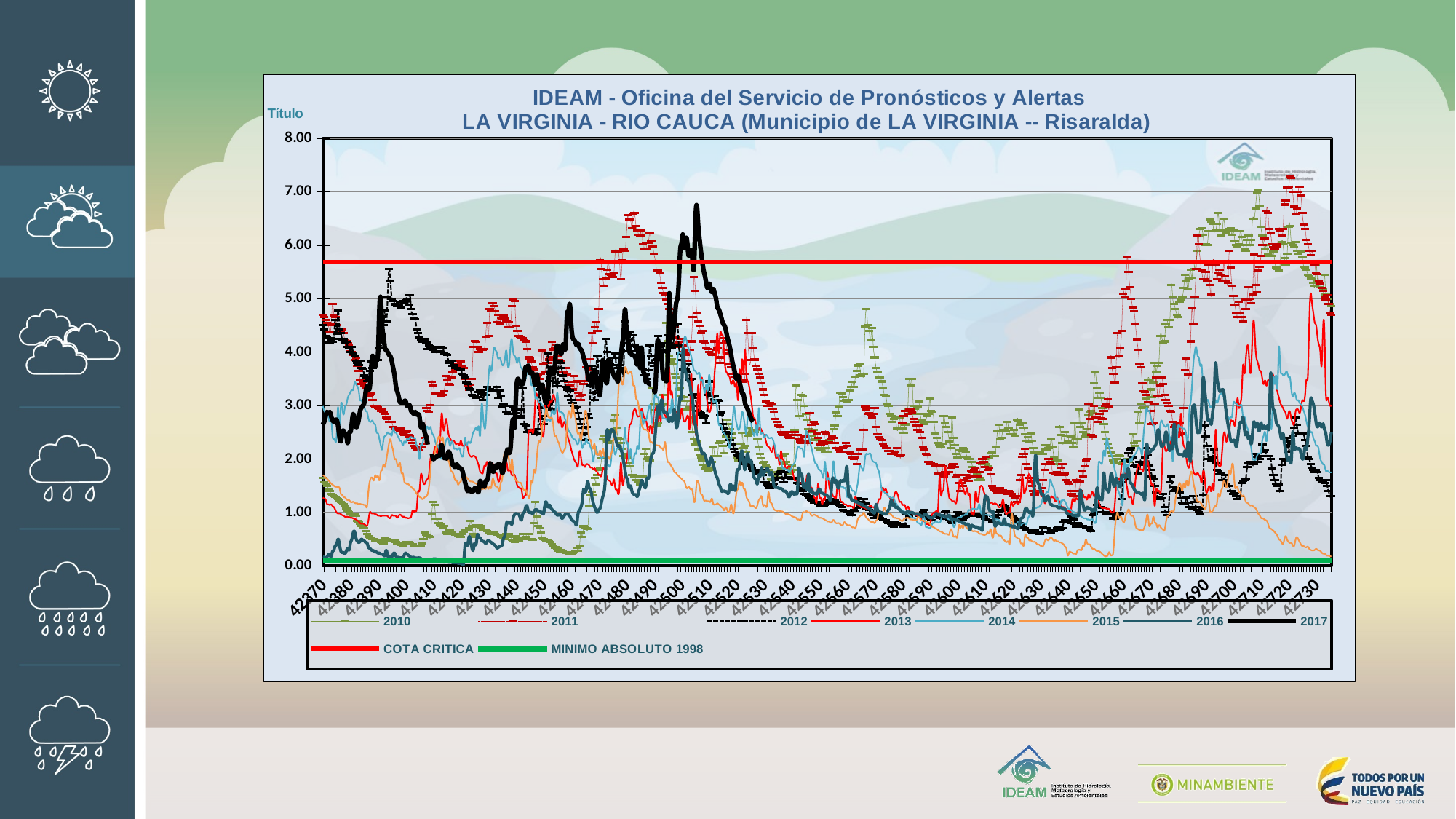
What is the highest tick value shown on the y axis? 8.00 Is the highest value reached by the 2010 series greater or less than 6.00? greater Is the value of the MINIMO ABSOLUTO 1998 line greater or less than 1.00? less Is the highest value reached by the 2017 series greater or less than 6.00? greater What kind of chart is shown on the slide? line chart How many series does the legend list? 10 What is the title of the chart? IDEAM - Oficina del Servicio de Pronósticos y Alertas LA VIRGINIA - RIO CAUCA (Municipio de LA VIRGINIA -- Risaralda) What is the first tick label on the x axis? 42370 What colour is the COTA CRITICA line in the chart? red How many tick labels are shown along the x axis? 37